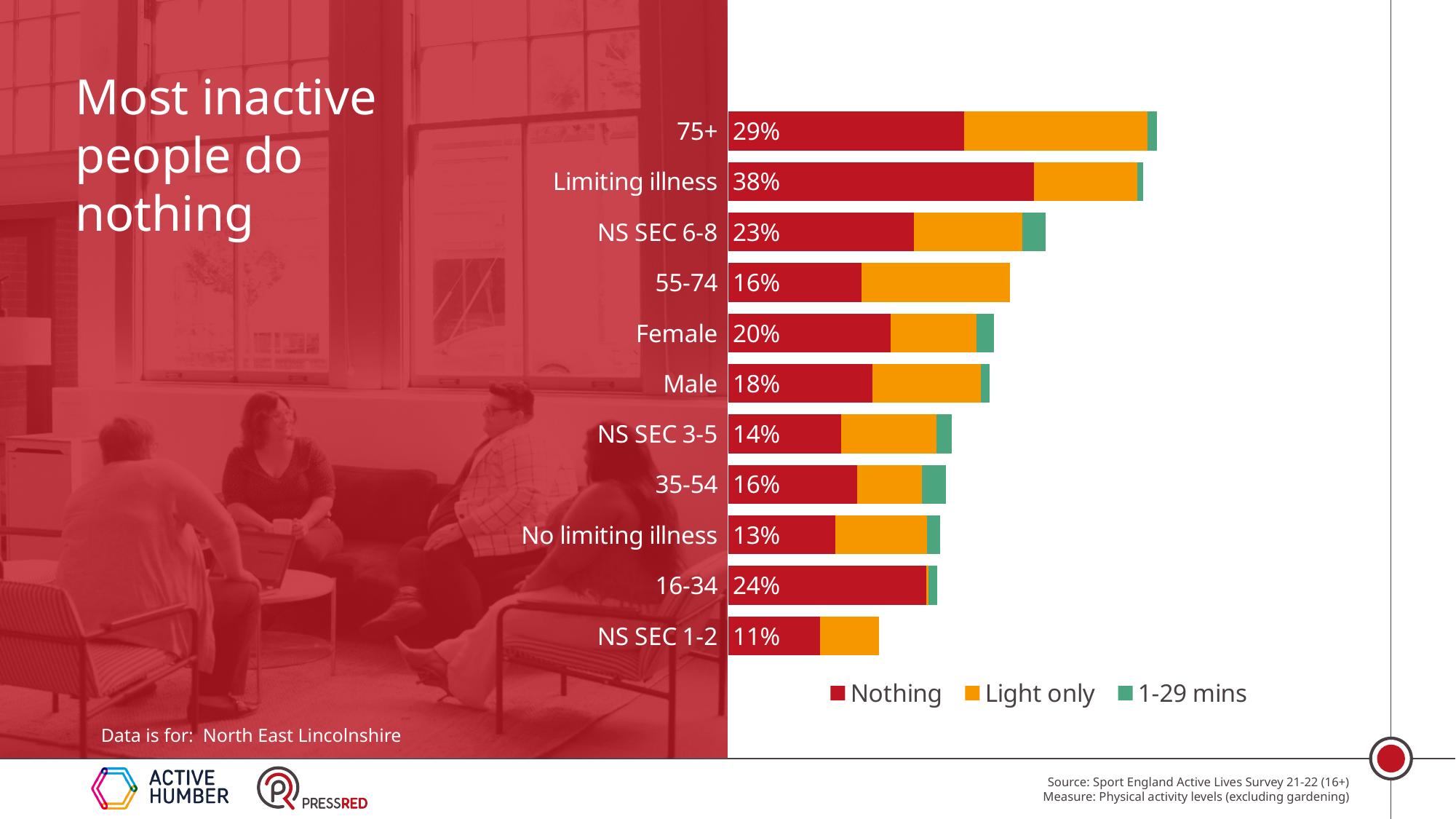
What are the three series named in the legend? Nothing, Light only, 1-29 mins Which category has the lowest 'Nothing' percentage? NS SEC 1-2 Which category has the highest 'Nothing' percentage? Limiting illness What is the 'Nothing' value for NS SEC 1-2? 11% How many categories are shown on the chart? 11 How many series does the legend list? 3 What is the difference in percentage points between the 'Nothing' values for Limiting illness and No limiting illness? 25 percentage points What is the 'Nothing' value for people with a limiting illness? 38% Which has a larger 'Nothing' value, Female or Male? Female What type of chart is shown on the slide? Stacked bar chart What percentage of people aged 75+ do nothing, according to the chart? 29% What is the 'Nothing' value for the 16-34 age group? 24%